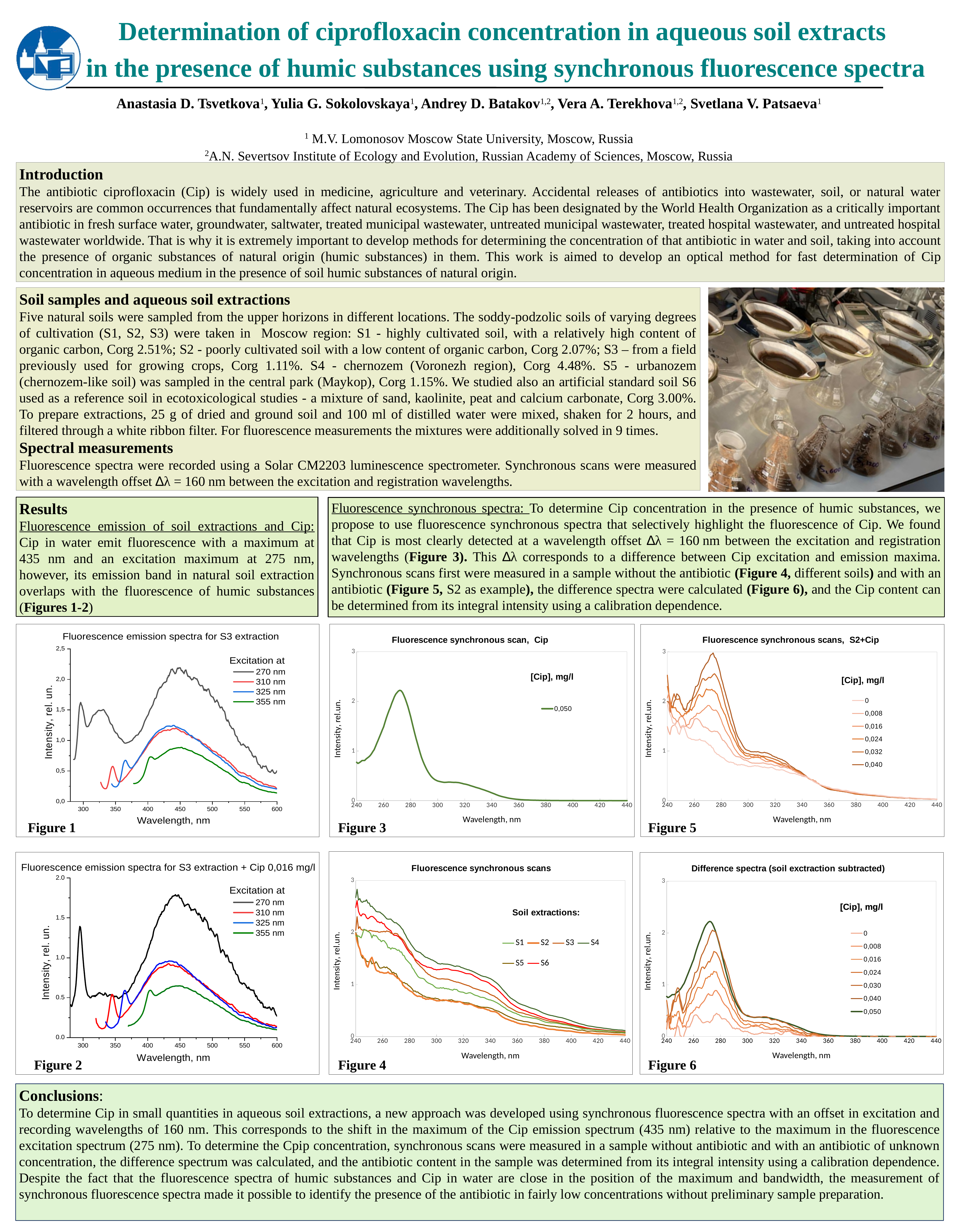
How many Cip concentrations does the legend of Figure 6 (Difference spectra) list? 7 In Figure 1 (Fluorescence emission spectra for S3 extraction), which excitation wavelength gives the lowest intensity curve? 355 nm In Figure 3 (Fluorescence synchronous scan, Cip), is the peak intensity greater or less than 2? greater In Figure 5 (Fluorescence synchronous scans, S2+Cip), which Cip concentration gives the highest peak intensity? 0,040 In Figure 4 (Fluorescence synchronous scans), which soil extraction has the highest intensity at 240 nm? S4 What kind of chart is Figure 1 (Fluorescence emission spectra for S3 extraction)? Line chart How many series does the legend of Figure 1 (Fluorescence emission spectra for S3 extraction) list? 4 In Figure 1 (Fluorescence emission spectra for S3 extraction), is the peak intensity of the 270 nm excitation curve greater or less than 2,0? greater How many series does the legend of Figure 3 (Fluorescence synchronous scan, Cip) list? 1 In Figure 2 (Fluorescence emission spectra for S3 extraction + Cip 0,016 mg/l), is the peak intensity of the 270 nm excitation curve greater or less than 1.5? greater In Figure 1 (Fluorescence emission spectra for S3 extraction), which excitation wavelength gives the highest intensity curve? 270 nm